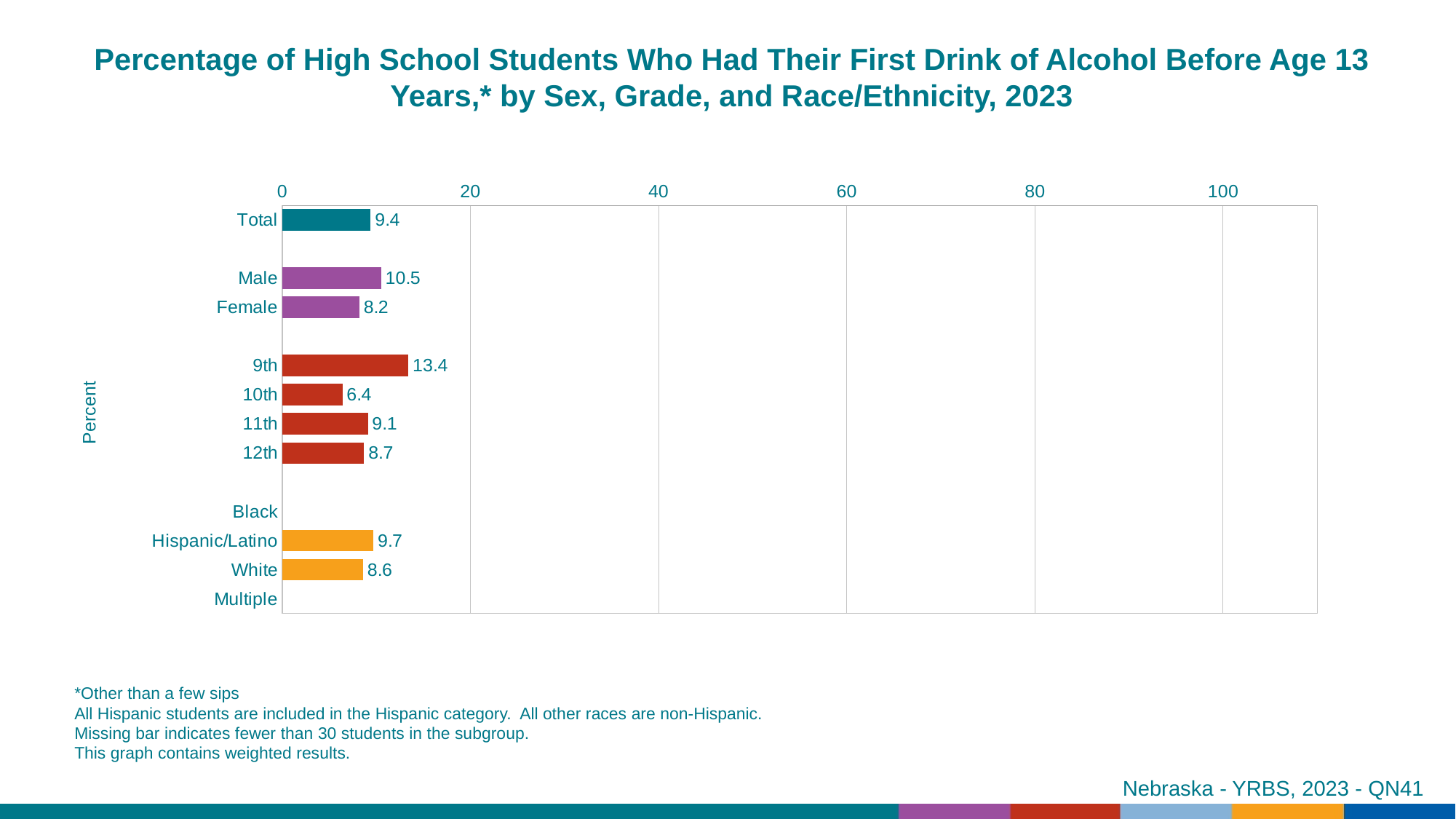
What is the value for 10th grade? 6.4 Which category has the highest value? 9th What is the value for Male? 10.5 What kind of chart is shown? bar chart What is the difference between the Male and Female values? 2.3 Which category with a plotted bar has the lowest value? 10th How many categories have a plotted bar? 9 Is the value for 9th grade greater or less than 20? less What is the value for Total? 9.4 Which is larger, the value for 11th grade or 12th grade? 11th Which categories have no bar shown? Black and Multiple What is the value for Hispanic/Latino? 9.7